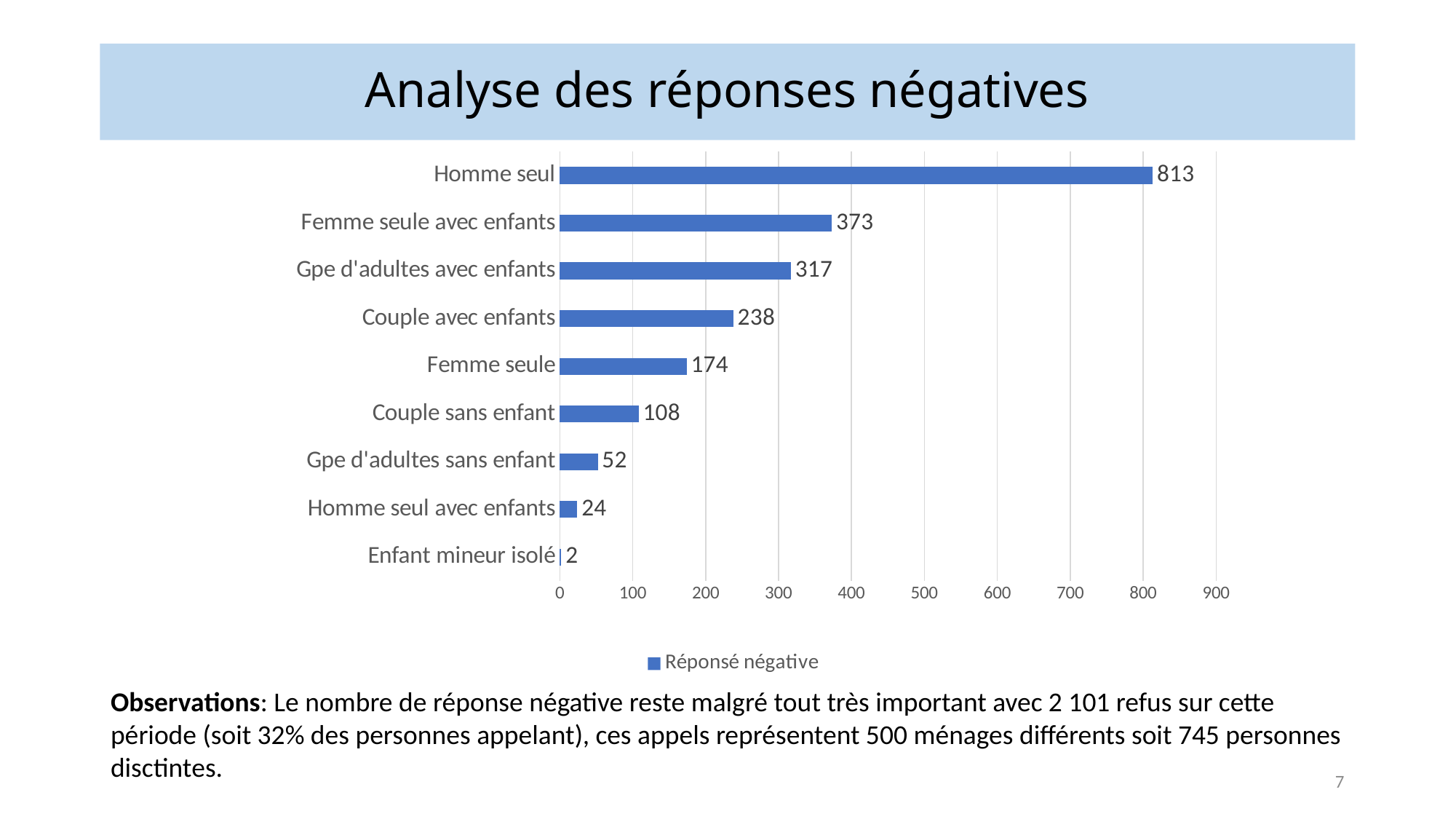
How many categories are shown in the chart? 9 Is the value for Femme seule greater or less than 200? less What kind of chart is shown on the slide? bar chart What series name does the legend show? Réponsé négative Which category has the lowest value? Enfant mineur isolé What is the value for Femme seule avec enfants? 373 What is the value for Couple sans enfant? 108 What is the difference between the values for Homme seul and Femme seule avec enfants? 440 What is the value for Homme seul? 813 Which is larger, the value for Gpe d'adultes avec enfants or the value for Couple avec enfants? Gpe d'adultes avec enfants What is the value for Enfant mineur isolé? 2 Which category has the highest value? Homme seul